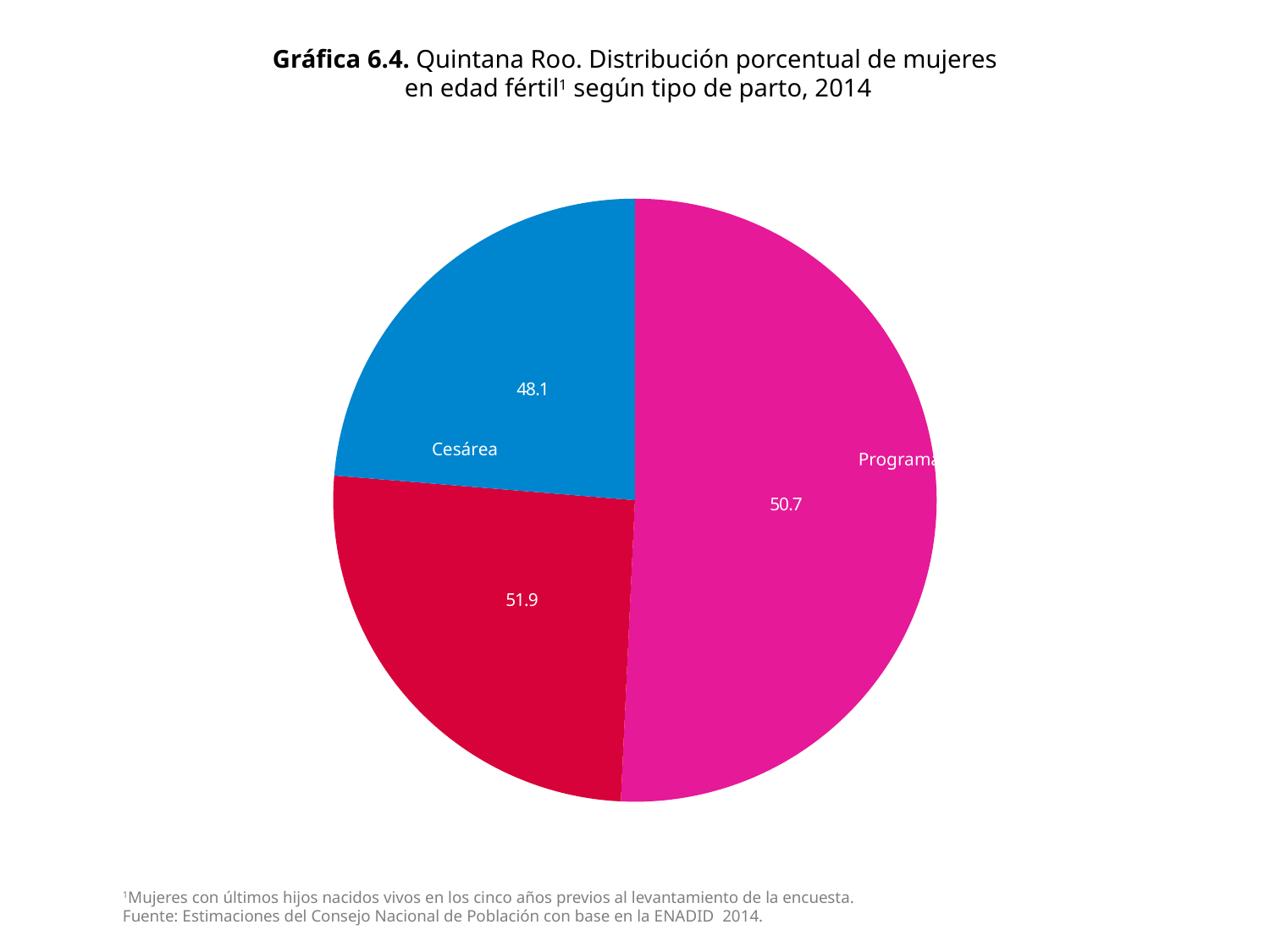
What colour is the Cesárea slice? blue What kind of chart is shown on the slide? pie chart What is the smallest value printed on the pie chart? 48.1 Is the value for Cesárea greater or less than 50? less What is the largest value printed on the pie chart? 51.9 Is the value for Cesárea larger or smaller than the value on the red slice? smaller Which year does the chart title refer to? 2014 What is the difference between the value on the red slice (51.9) and the Cesárea value (48.1)? 3.8 What value is shown for the Cesárea slice? 48.1 How many slices does the pie chart have? 3 Which slice has the smallest printed value? Cesárea